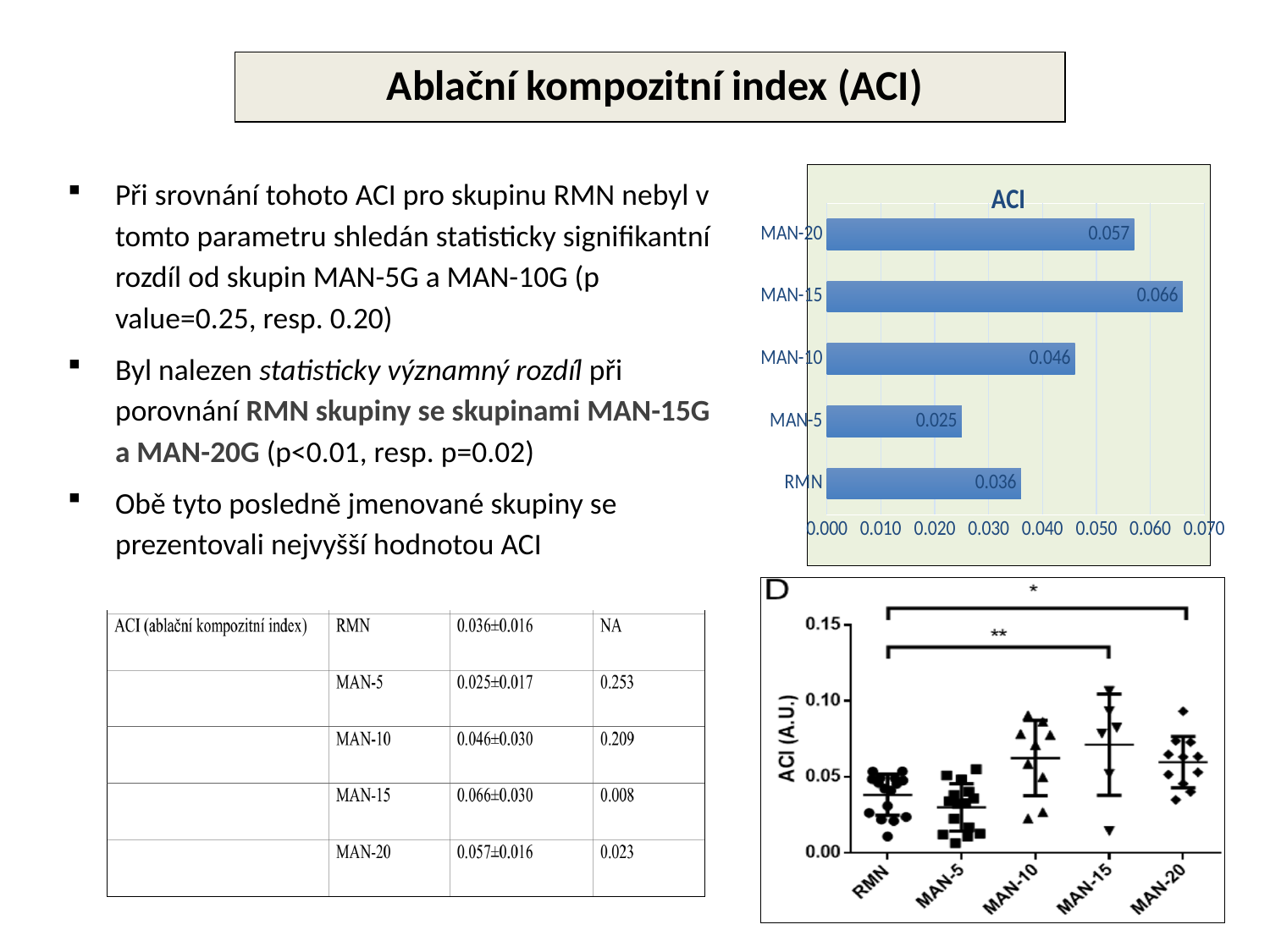
In the bar chart titled ACI, what is the value for RMN? 0.036 In the bar chart titled ACI, is the value for MAN-20 greater or less than 0.050? greater In the bar chart titled ACI, what is the value for MAN-5? 0.025 In the bar chart titled ACI, which category has the lowest value? MAN-5 In the bar chart titled ACI, what is the value for MAN-15? 0.066 What kind of chart is the chart titled ACI in the upper right of the slide? bar chart How many categories are shown in the bar chart titled ACI? 5 In the bar chart titled ACI, what is the difference between the values for MAN-15 and RMN? 0.030 In the bar chart titled ACI, which category has the highest value? MAN-15 In the scatter plot labelled D at the bottom right, how many groups are shown on the x axis? 5 In the bar chart titled ACI, which is larger, the value for MAN-10 or the value for RMN? MAN-10 In the bar chart titled ACI, what is the difference between the values for MAN-20 and MAN-10? 0.011